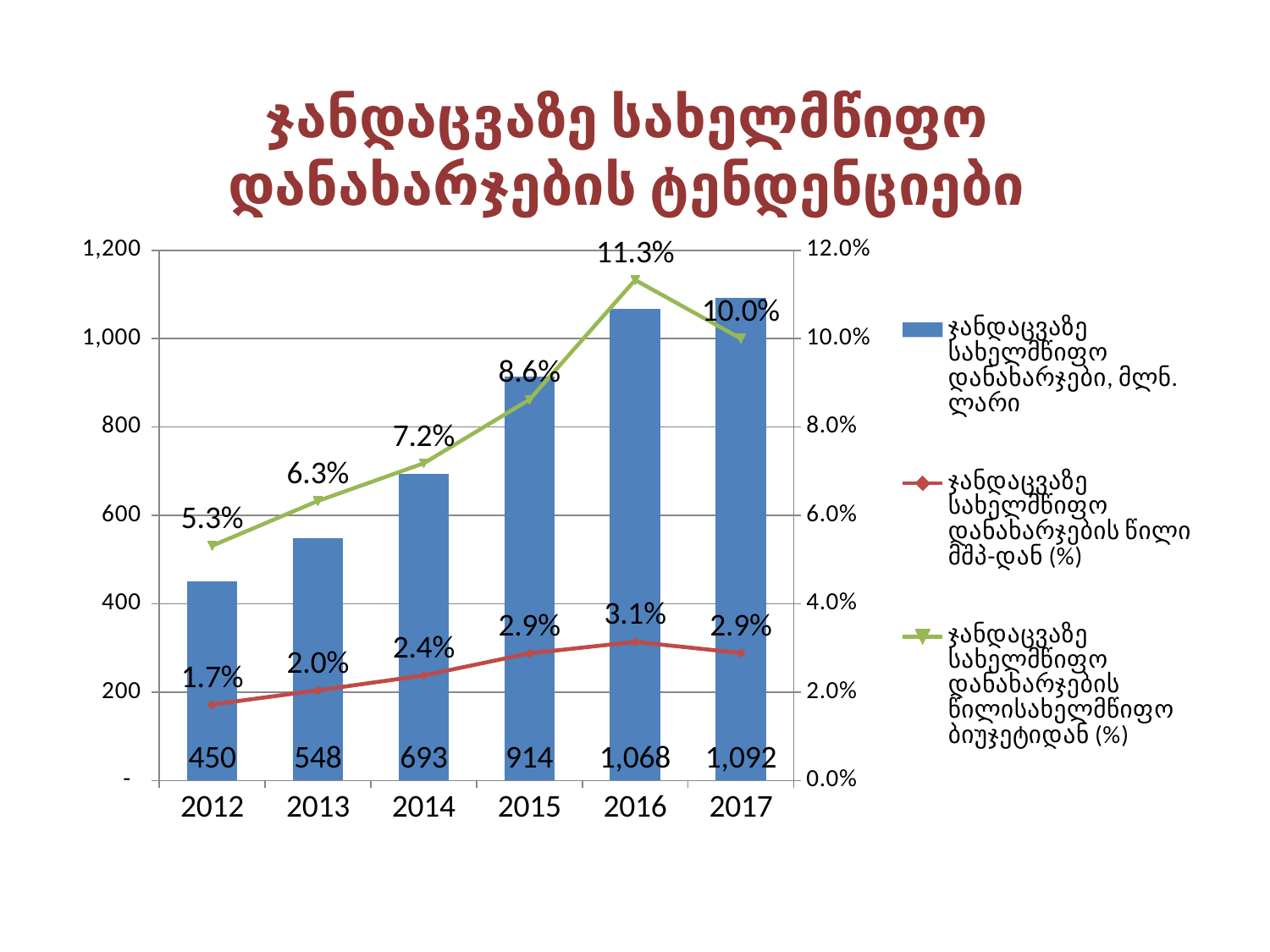
What is the difference between the blue bar values for 2017 and 2016? 24 In which year is the green line (share of state budget) lowest? 2012 How many years are shown on the x axis? 6 What is the value of the red line (წილი მშპ-დან, %) for 2014? 2.4% What is the value of the green line (წილი სახელმწიფო ბიუჯეტიდან, %) for 2016? 11.3% What is the difference between the red line values for 2016 and 2012? 1.4% Which is larger: the green line value for 2016 or for 2017? 2016 In which year is the blue bar (state health expenditure, mln GEL) highest? 2017 What kind of chart is shown on the slide? Combined bar and line chart How many series does the legend list? 3 Do the blue bar values rise or fall from 2012 to 2017? Rise What is the value of the blue bar (ჯანდაცვაზე სახელმწიფო დანახარჯები, მლნ. ლარი) for 2015? 914